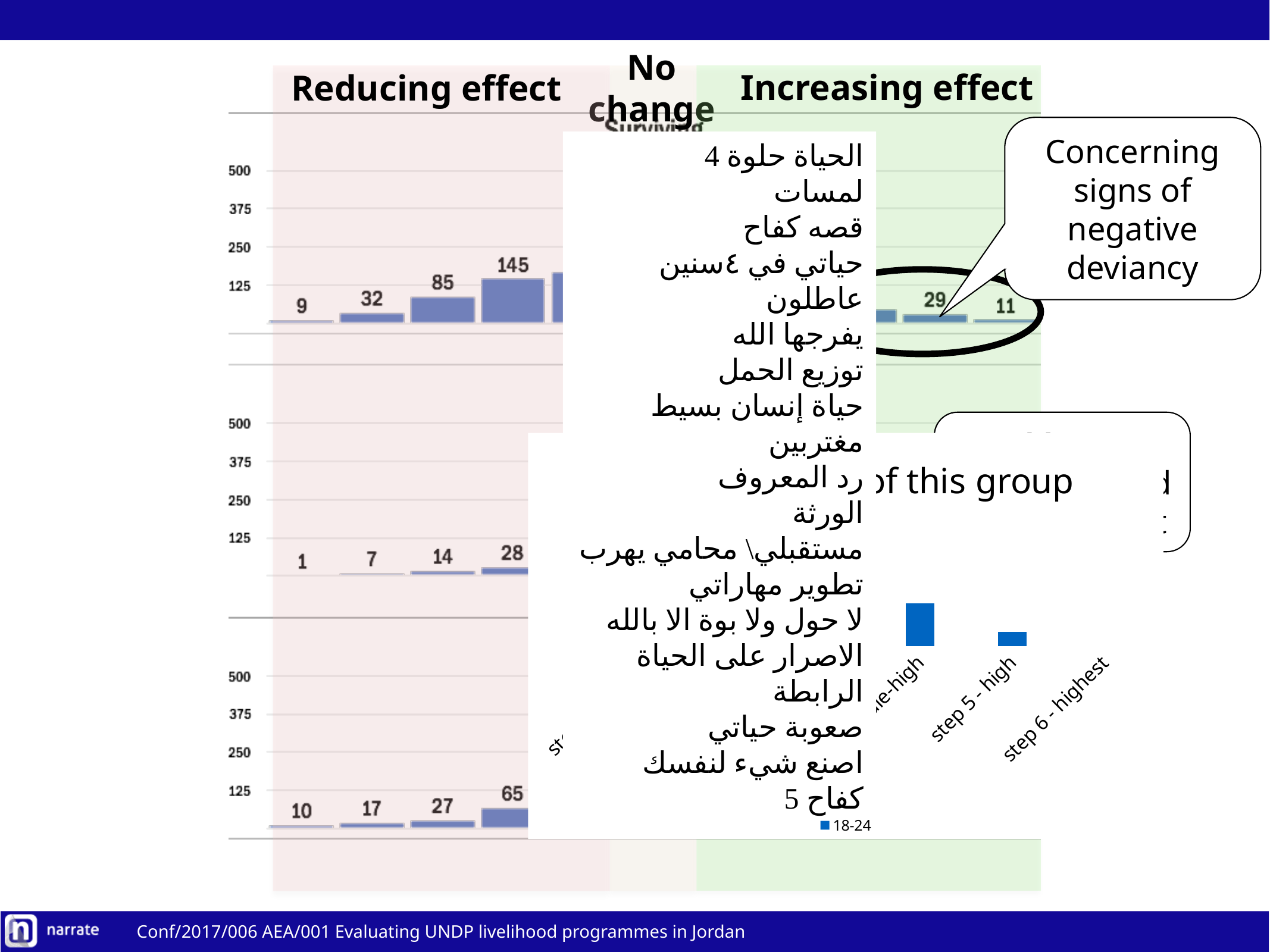
In the bottom chart, what is the difference between the bar labelled 65 and the bar labelled 27? 38 In the top chart, what is the value of the fourth bar from the left? 145 Which is larger, the second bar of the top chart or the second bar of the bottom chart? the second bar of the top chart (32) What kind of chart are the three charts on the left of the slide? bar chart In the top chart, what is the value of the leftmost bar? 9 In the bottom chart, what is the value of the fourth bar from the left? 65 In the top chart, what is the difference between the bar labelled 145 and the bar labelled 85? 60 In the top chart, what is the value of the rightmost bar? 11 In the middle chart, what is the value of the leftmost bar? 1 In the top chart, which is larger, the bar labelled 29 or the bar labelled 11? 29 In the middle chart, do the visible values rise or fall from left to right? rise What is the highest tick value shown on the y axis of the charts? 500